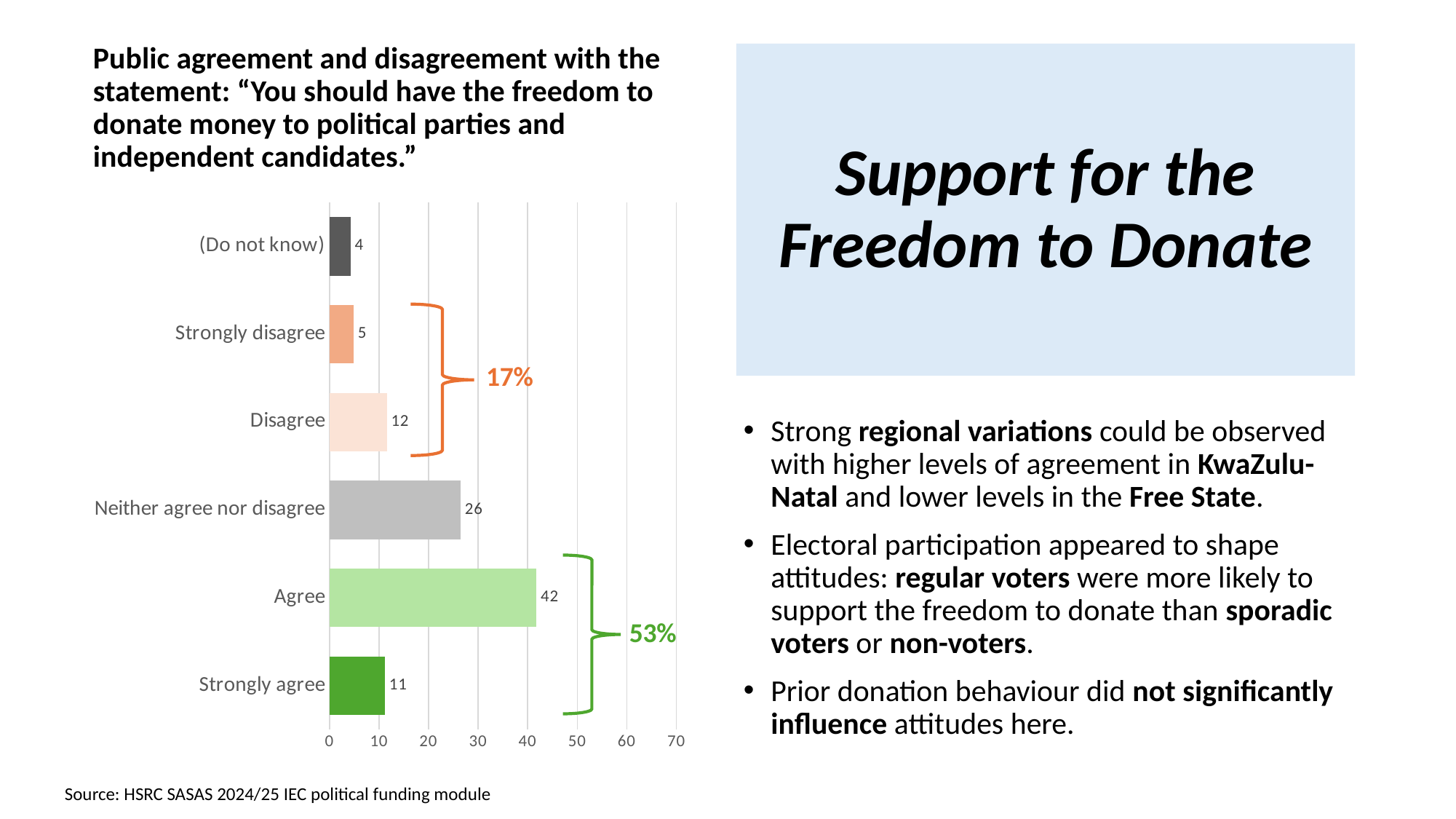
What is the value for Agree? 42 What is the value for Strongly disagree? 5 What is the difference between the values for Agree and Strongly agree? 31 Which category has the lowest value? (Do not know) Which category has the highest value? Agree What kind of chart is shown on the slide? Bar chart What is the value for Neither agree nor disagree? 26 How many categories are shown on the chart? 6 Is the value for Neither agree nor disagree greater or less than 20? greater What is the value for (Do not know)? 4 What combined percentage is shown by the green bracket grouping Agree and Strongly agree? 53% Which is larger, the value for Disagree or the value for Strongly agree? Disagree